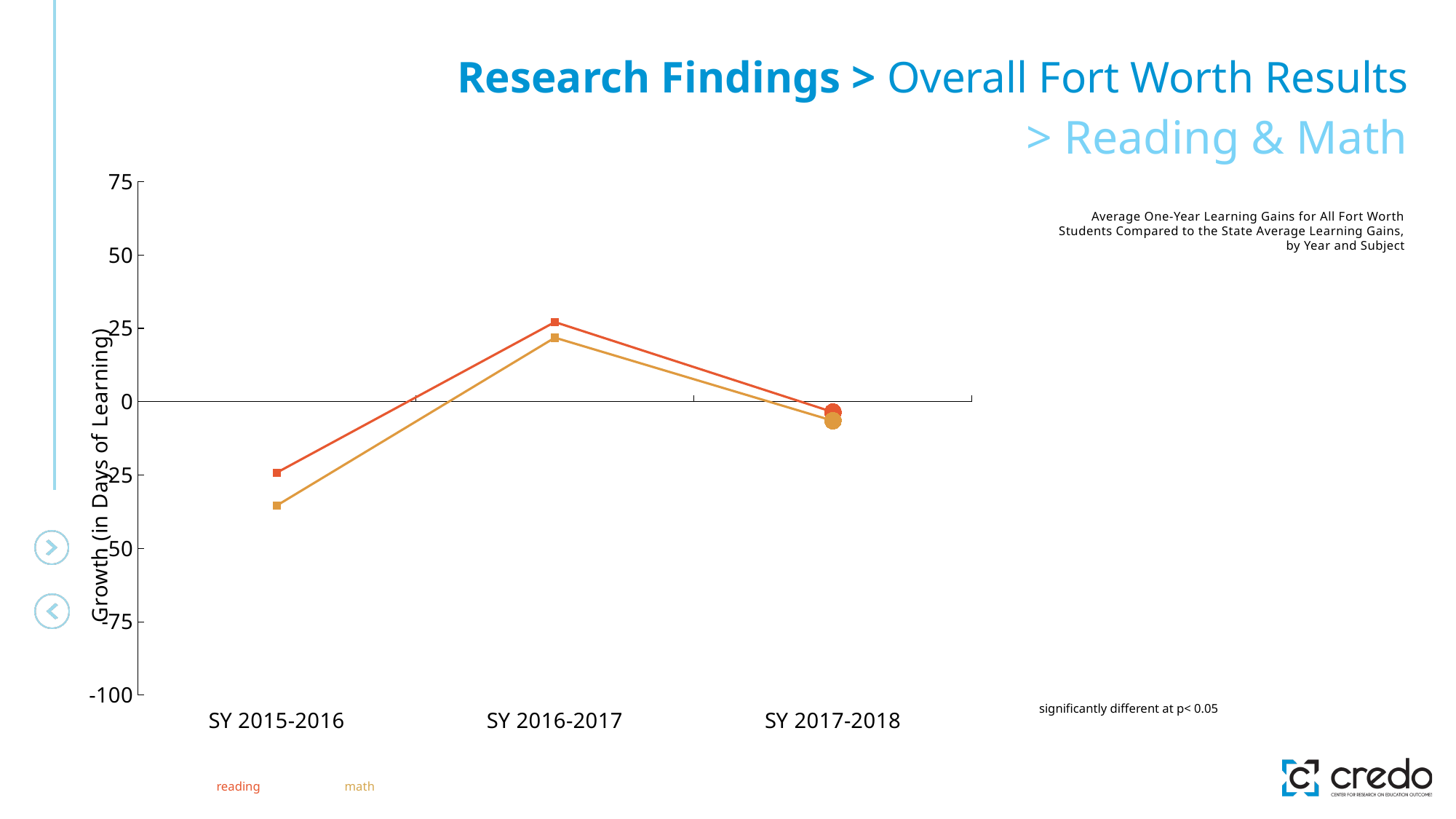
Is the value for math in SY 2017-2018 greater or less than 0? less In which school year does the math series reach its lowest value? SY 2015-2016 Is the value for math in SY 2015-2016 greater or less than -25? less Is the value for math in SY 2016-2017 greater or less than 0? greater In SY 2015-2016, which series has the larger value, reading or math? reading How many school years are plotted on the x axis? 3 What kind of chart is shown on the slide? line chart In which school year does the reading series reach its highest value? SY 2016-2017 What is the label on the y axis of the chart? Growth (in Days of Learning) How many series does the legend list? 2 Do the values for reading rise or fall from SY 2016-2017 to SY 2017-2018? fall